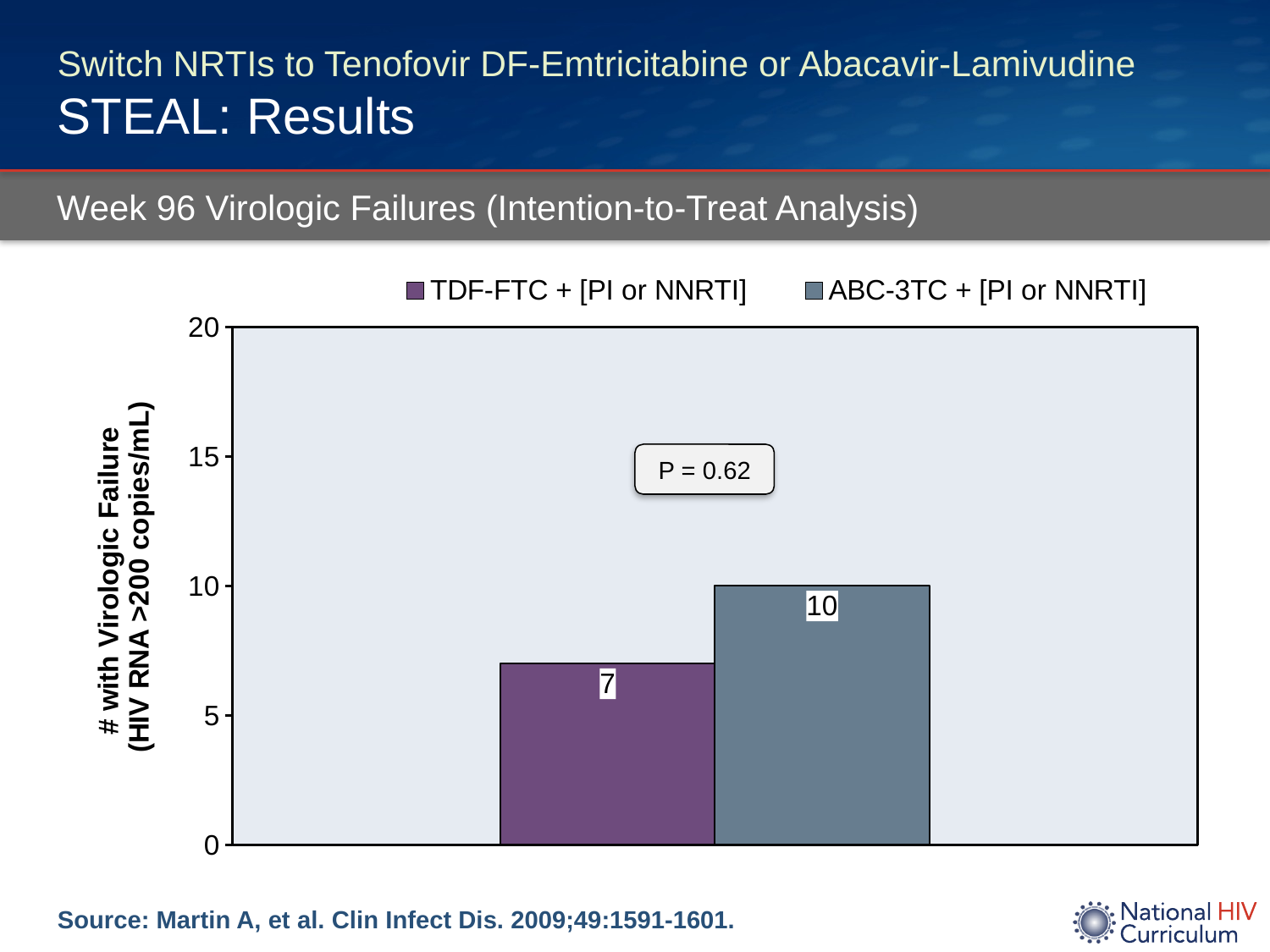
What is the maximum value shown on the y axis? 20 What kind of chart is shown on the slide? Bar chart Is the value for TDF-FTC + [PI or NNRTI] greater or less than 10? less What is the number of virologic failures for TDF-FTC + [PI or NNRTI]? 7 Which group has the higher number of virologic failures? ABC-3TC + [PI or NNRTI] What P value is shown on the chart? P = 0.62 Which group has the lower number of virologic failures? TDF-FTC + [PI or NNRTI] What is the difference in virologic failures between ABC-3TC + [PI or NNRTI] and TDF-FTC + [PI or NNRTI]? 3 Is the value for ABC-3TC + [PI or NNRTI] greater or less than 5? greater What is the number of virologic failures for ABC-3TC + [PI or NNRTI]? 10 How many series does the legend list? 2 Is the number of virologic failures greater for TDF-FTC + [PI or NNRTI] or ABC-3TC + [PI or NNRTI]? ABC-3TC + [PI or NNRTI]